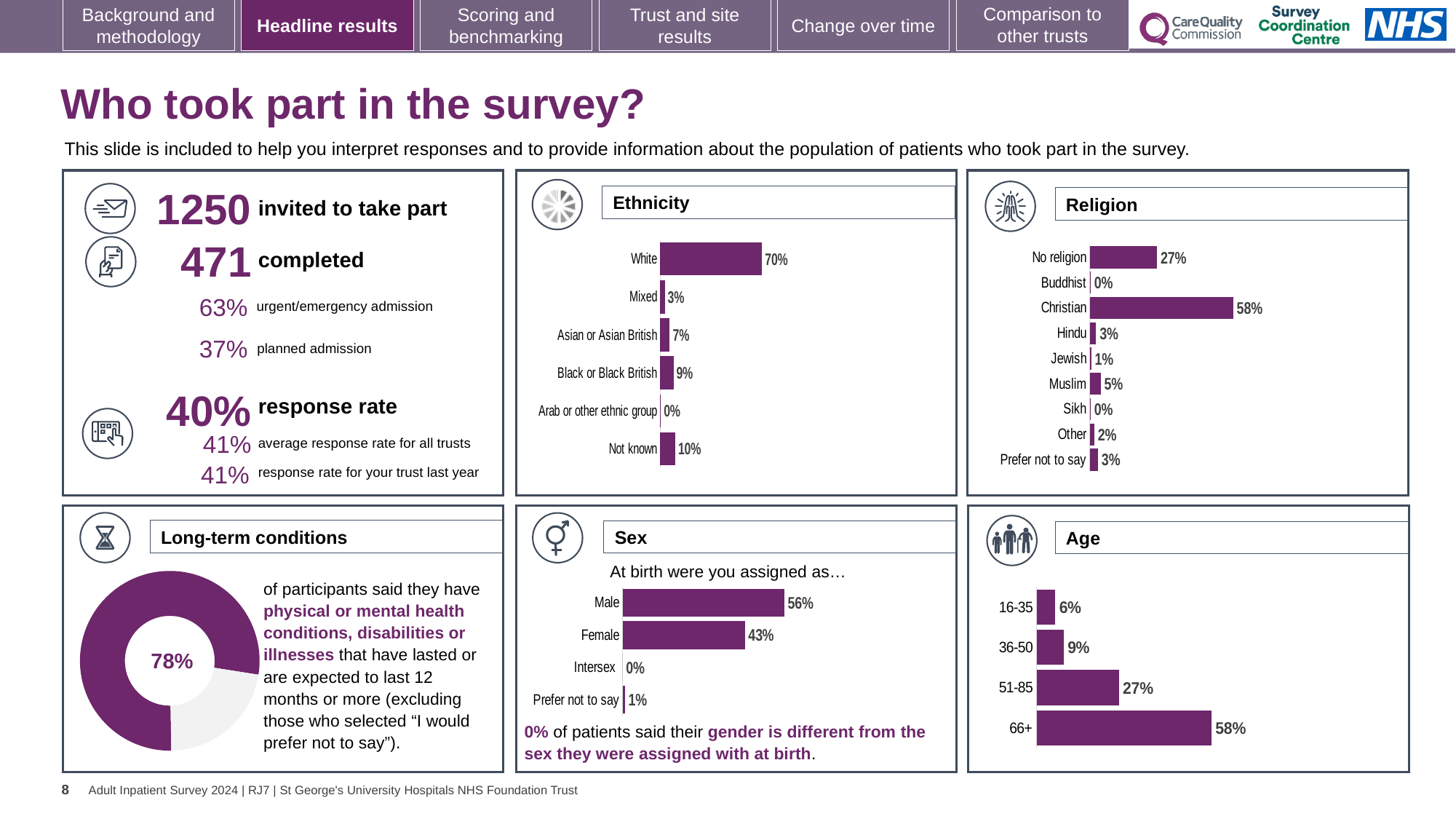
In the Ethnicity chart, which category has the highest value? White In the Long-term conditions chart, what share of participants said they have physical or mental health conditions, disabilities or illnesses? 78% In the Sex chart, what percentage of respondents were Female? 43% In the Sex chart, what is the difference between Male and Female? 13% In the Ethnicity chart, what percentage of respondents were White? 70% In the Religion chart, which is larger, Muslim or Hindu? Muslim In the Religion chart, what is the difference between Christian and No religion? 31% In the Religion chart, what percentage of respondents were Christian? 58% In the Ethnicity chart, how many categories are shown? 6 In the Age chart, do the values rise or fall as age increases from 16-35 to 66+? rise In the Age chart, which age group has the lowest value? 16-35 In the Religion chart, how many categories are shown? 9